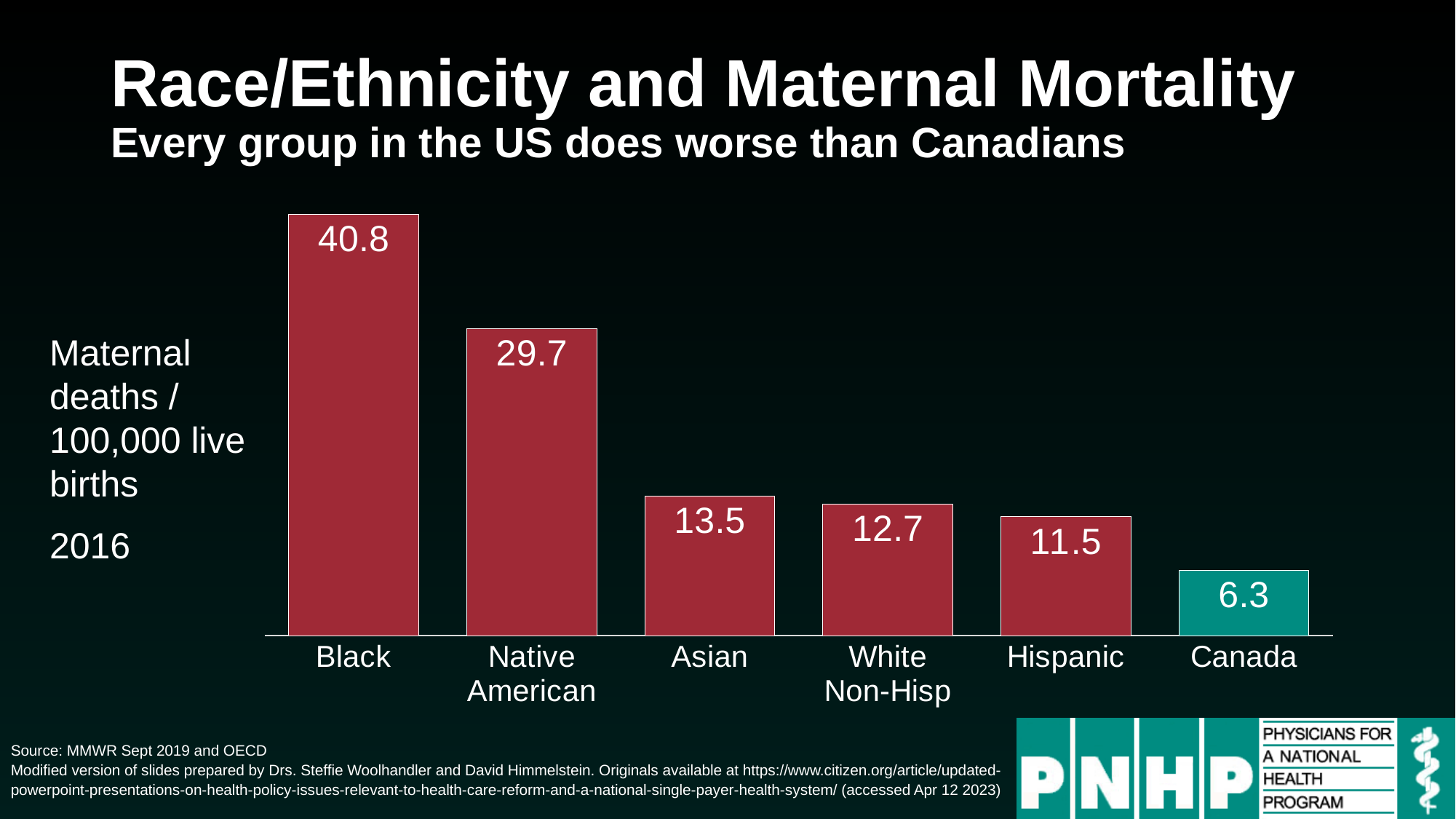
What is the maternal mortality value for Canada? 6.3 What is the value shown for Native American? 29.7 What is the maternal mortality value for Black? 40.8 What is the value shown for White Non-Hisp? 12.7 What is the difference between the values for Black and Canada? 34.5 Which bar is shown in a different colour from the others? Canada Which category has the lowest maternal mortality? Canada What kind of chart is shown on the slide? Bar chart Which category has the highest maternal mortality? Black Which is larger, the value for Asian or the value for White Non-Hisp? Asian What is the difference between the values for Asian and Hispanic? 2.0 How many categories are shown on the chart? 6